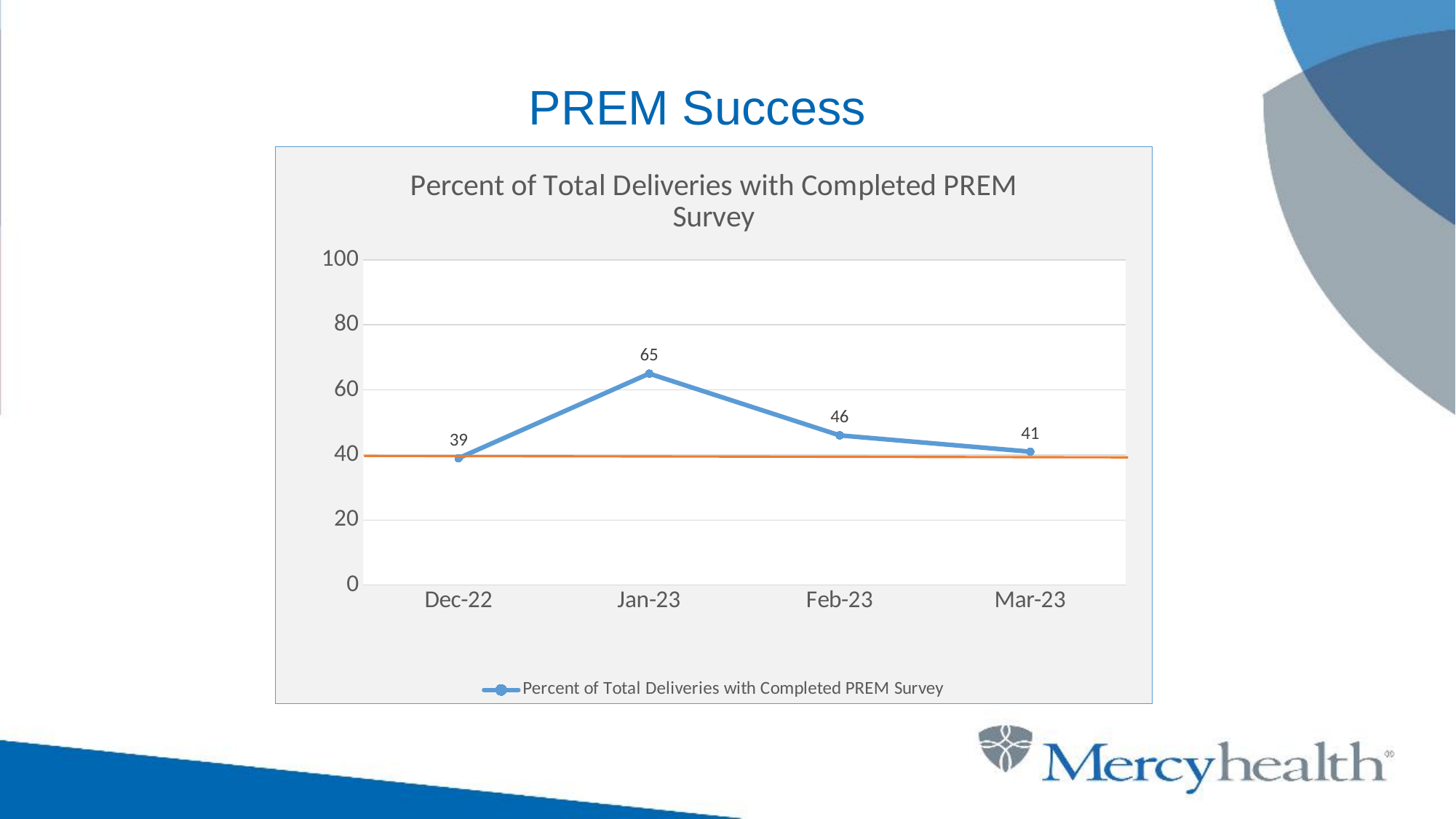
What is the title of the chart? Percent of Total Deliveries with Completed PREM Survey Does the value rise or fall from Jan-23 to Mar-23? Fall What is the difference between the values for Jan-23 and Feb-23? 19 What is the value for Dec-22? 39 What is the value for Mar-23? 41 Which month has the lowest percent of total deliveries with completed PREM survey? Dec-22 How many months are plotted on the x axis? 4 Which is larger, the value for Feb-23 or the value for Mar-23? Feb-23 What kind of chart is shown on the slide? Line chart What is the value for Feb-23? 46 What is the value for Jan-23? 65 Which month has the highest percent of total deliveries with completed PREM survey? Jan-23